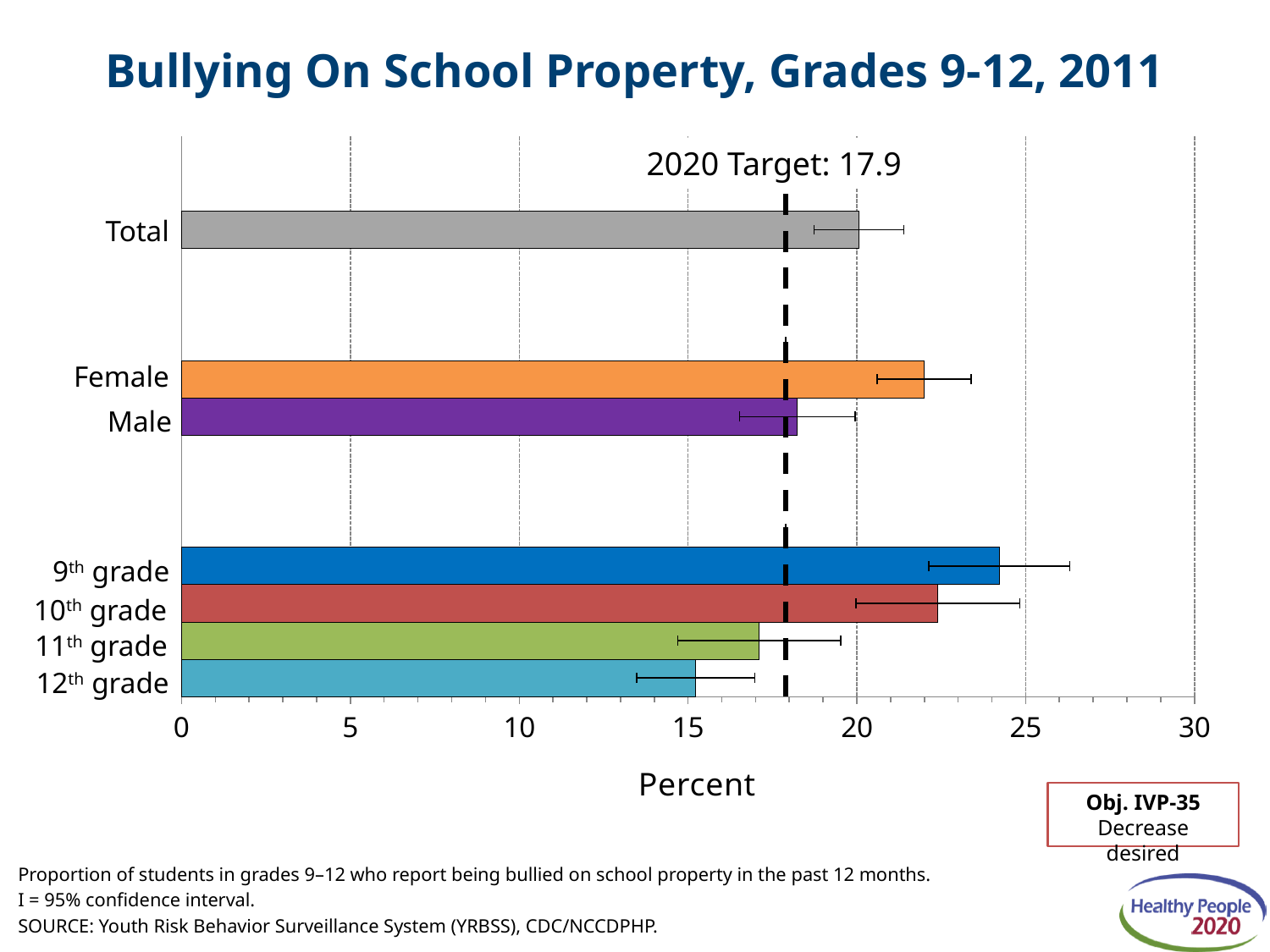
What is the 2020 Target value shown on the chart? 17.9 Which is larger, the value for 9th grade or the value for 12th grade? 9th grade How many categories (bars) are plotted in the chart? 7 Is the value for 9th grade greater or less than 20? greater Which category has the lowest value in the chart? 12th grade Is the value for Female greater or less than 20? greater What kind of chart is shown on the slide? bar chart Is the value for 11th grade greater or less than 20? less Do the values rise or fall going from 9th grade to 12th grade? fall Which category has the highest value in the chart? 9th grade Which is larger, the value for Female or the value for Male? Female